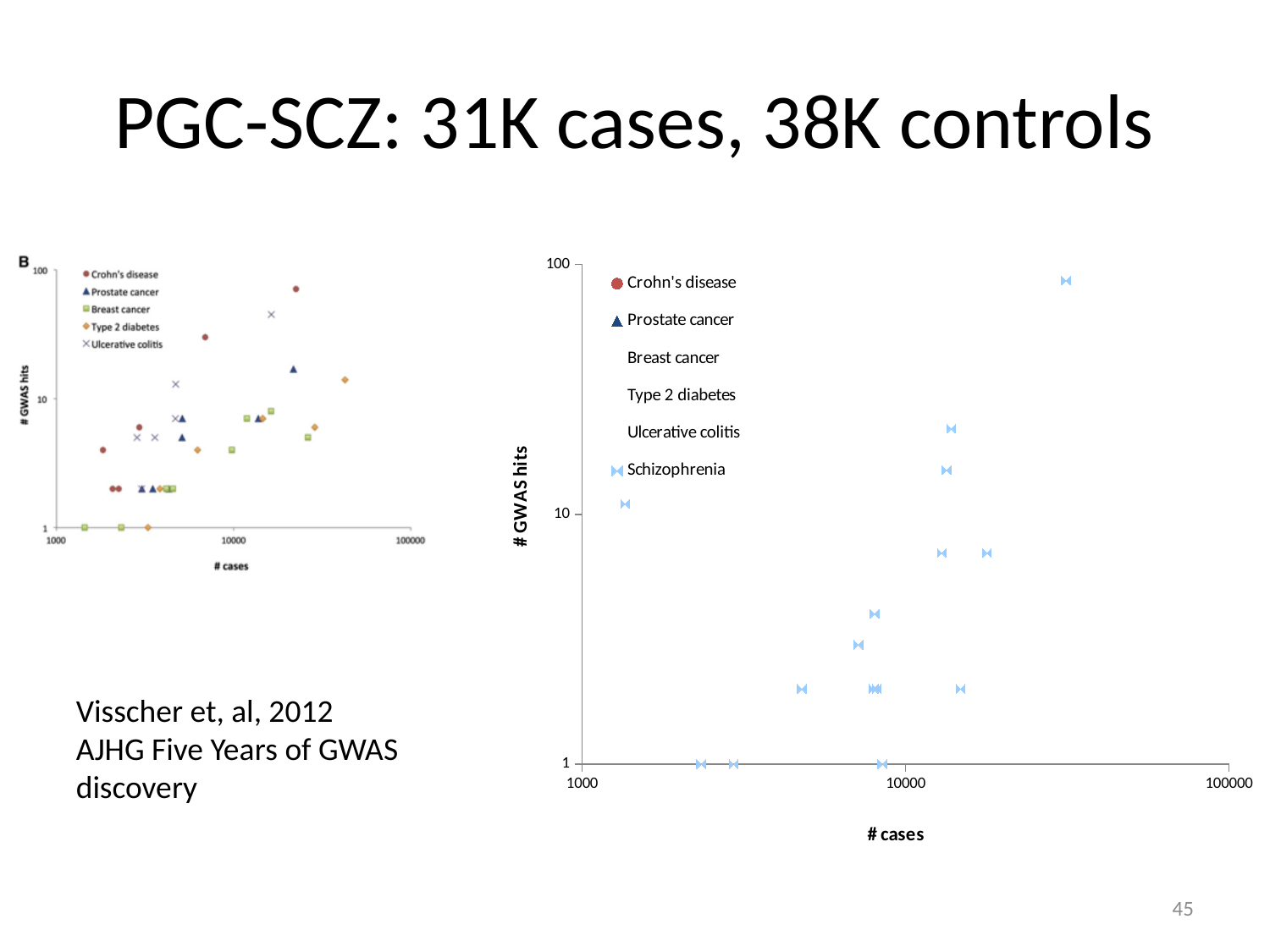
What kind of chart is the chart on the right of the slide? scatter chart On the right-hand chart, what is the lowest # GWAS hits value at which Schizophrenia points are plotted? 1 What is the label of the x axis on the right-hand chart? # cases On the right-hand chart, which series is the only one with plotted points? Schizophrenia On the right-hand chart, what is the largest value shown on the x axis? 100000 How many series does the legend of the left-hand chart (panel B) list? 5 How many series does the legend of the right-hand chart list? 6 What is the label of the y axis on the right-hand chart? # GWAS hits On the right-hand chart, is the # GWAS hits value of the highest Schizophrenia point greater or less than 10? greater On the left-hand chart (panel B), which series has the point with the highest # GWAS hits? Crohn's disease On the right-hand chart, is the # cases value of the highest Schizophrenia point greater or less than 10000? greater On the left-hand chart (panel B), is the # GWAS hits value of the highest Type 2 diabetes point greater or less than 10? greater